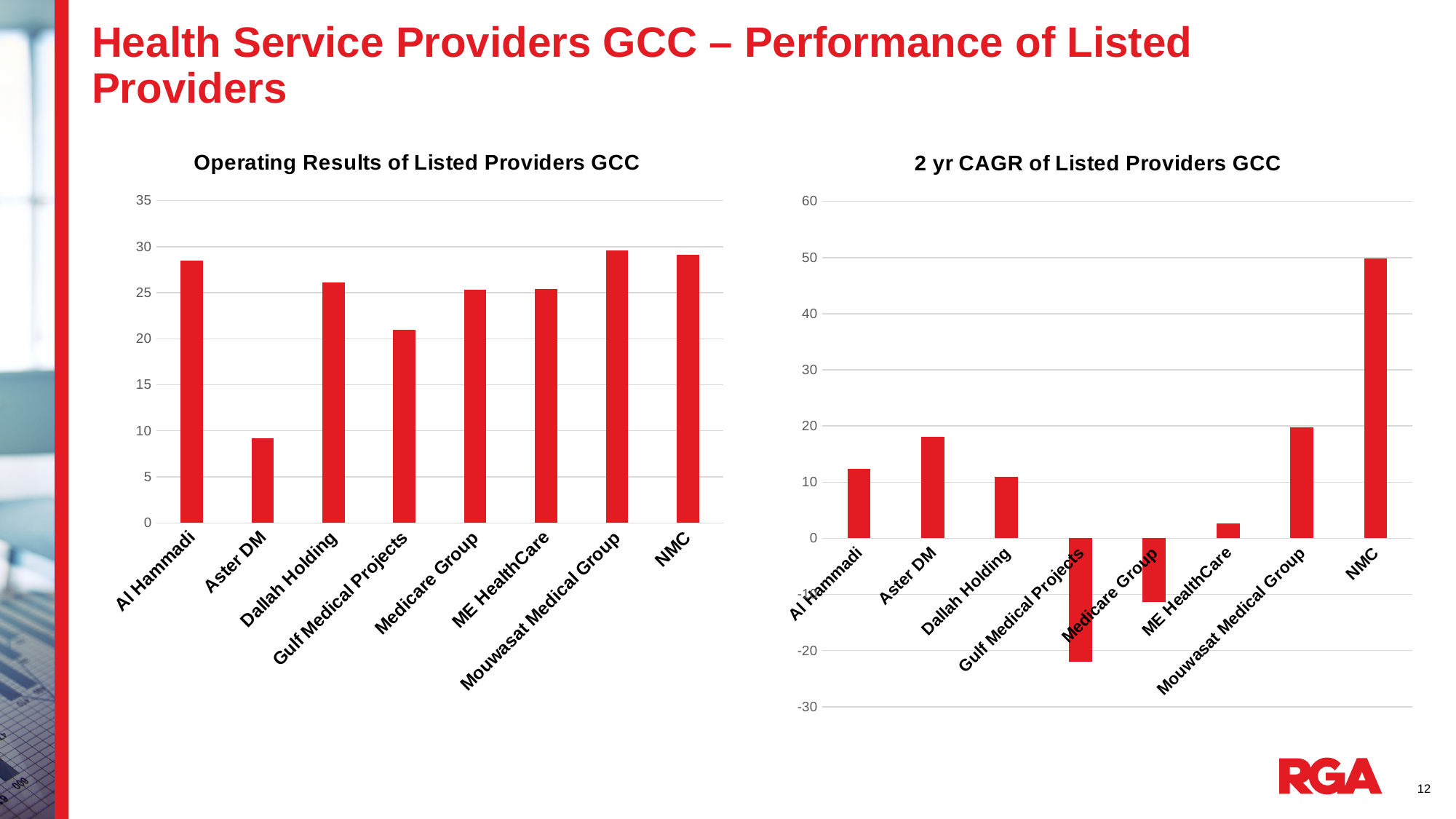
In the 'Operating Results of Listed Providers GCC' chart, which provider has the lowest value? Aster DM In the 'Operating Results of Listed Providers GCC' chart, is the value for Gulf Medical Projects greater or less than 20? greater In the '2 yr CAGR of Listed Providers GCC' chart, which is larger, the value for Aster DM or the value for Dallah Holding? Aster DM In the '2 yr CAGR of Listed Providers GCC' chart, which provider has the lowest value? Gulf Medical Projects In the '2 yr CAGR of Listed Providers GCC' chart, is the value for NMC greater or less than 40? greater What is the title of the chart on the right side of the slide? 2 yr CAGR of Listed Providers GCC In the 'Operating Results of Listed Providers GCC' chart, is the value for Aster DM greater or less than 10? less In the 'Operating Results of Listed Providers GCC' chart, which is larger, the value for Al Hammadi or the value for Aster DM? Al Hammadi In the '2 yr CAGR of Listed Providers GCC' chart, which provider has the highest value? NMC In the 'Operating Results of Listed Providers GCC' chart, what kind of chart is shown? Bar chart In the 'Operating Results of Listed Providers GCC' chart, how many providers are plotted? 8